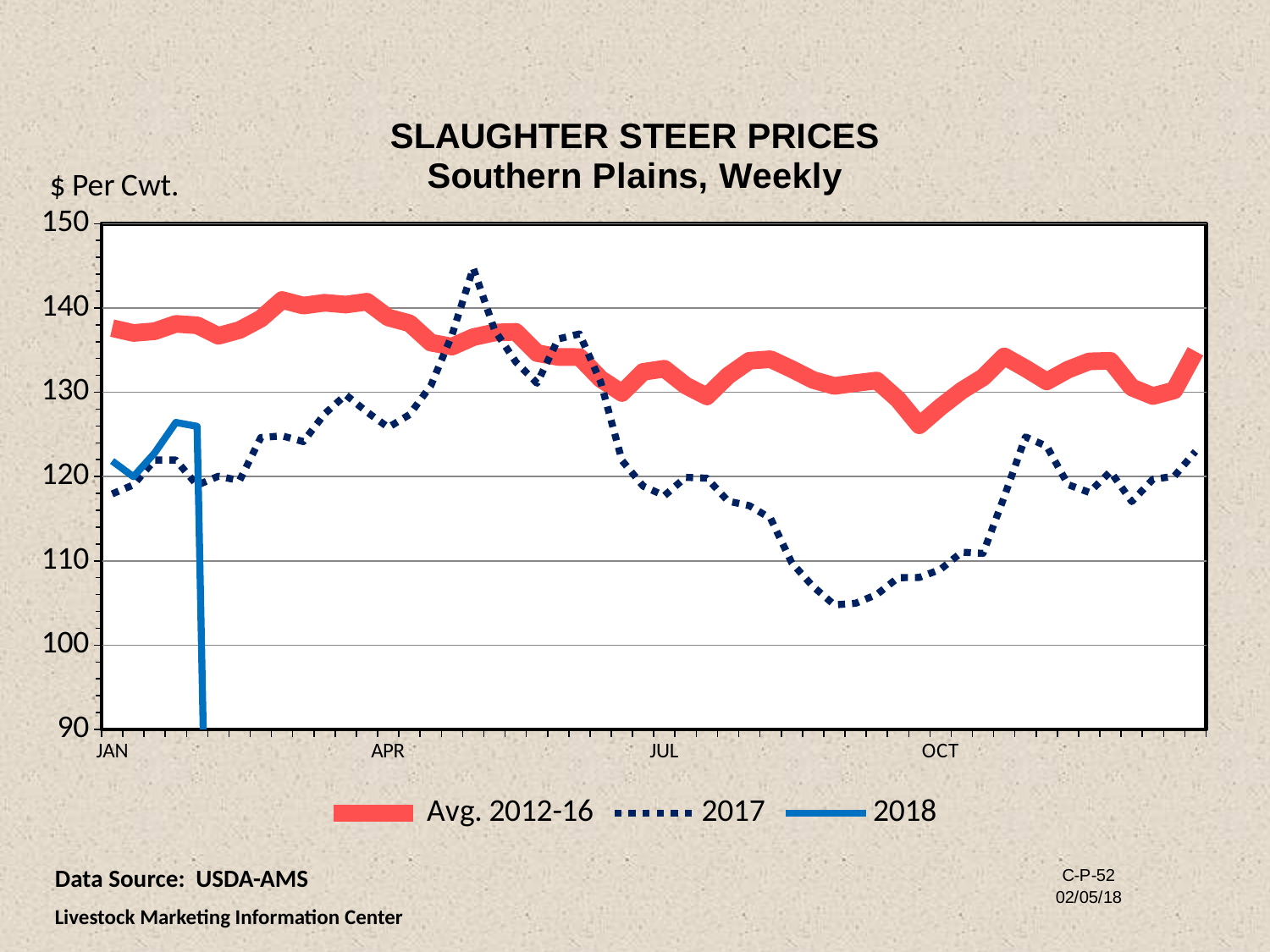
In early January, which series is higher, Avg. 2012-16 or 2017? Avg. 2012-16 At the late-April peak of the 2017 series, which is higher, 2017 or Avg. 2012-16? 2017 How many series does the legend list? 3 Is the peak value of the 2017 series in late April greater or less than 140? greater Does the 2017 series rise or fall between July and September? fall What is the title of the chart? SLAUGHTER STEER PRICES Southern Plains, Weekly What kind of chart is shown on the slide? line chart Is the value for the Avg. 2012-16 series at the start of January greater or less than 130? greater Is the highest value of the 2018 series greater or less than 130? less What unit is shown on the y-axis label? $ Per Cwt.